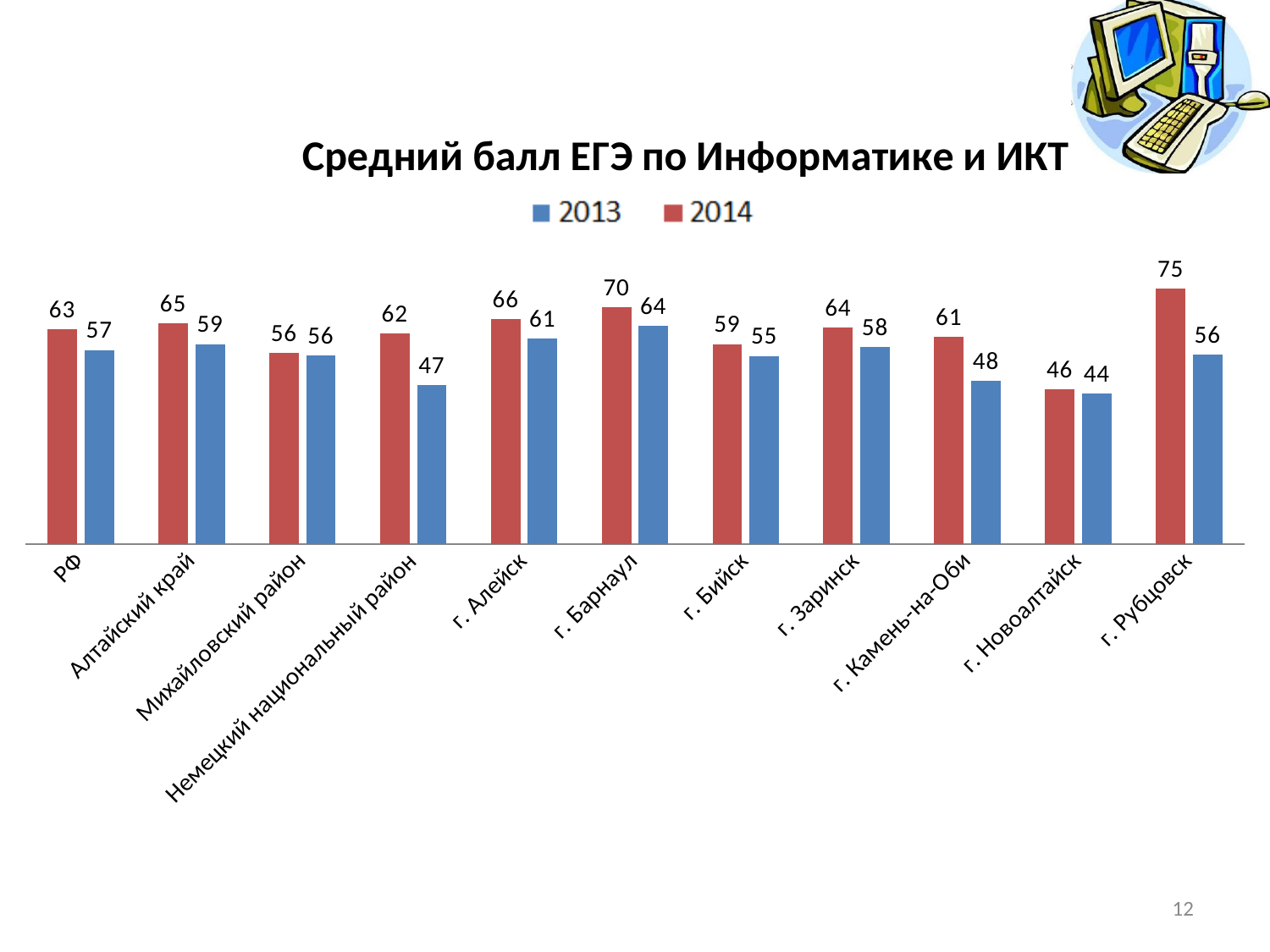
What is the difference between the 2014 values for г. Барнаул and г. Бийск? 11 How many series does the legend list? 2 What is the 2013 value for г. Барнаул? 64 What is the 2014 value for г. Рубцовск? 75 Which category has the highest 2014 value? г. Рубцовск What is the title of the chart? Средний балл ЕГЭ по Информатике и ИКТ Which category has the lowest 2013 value? г. Новоалтайск How many categories are shown on the x axis? 11 Which is larger: the 2014 value for Алтайский край or the 2014 value for РФ? Алтайский край What kind of chart is shown on the slide? bar chart What is the difference between the 2014 and 2013 values for г. Рубцовск? 19 What is the 2013 value for Немецкий национальный район? 47